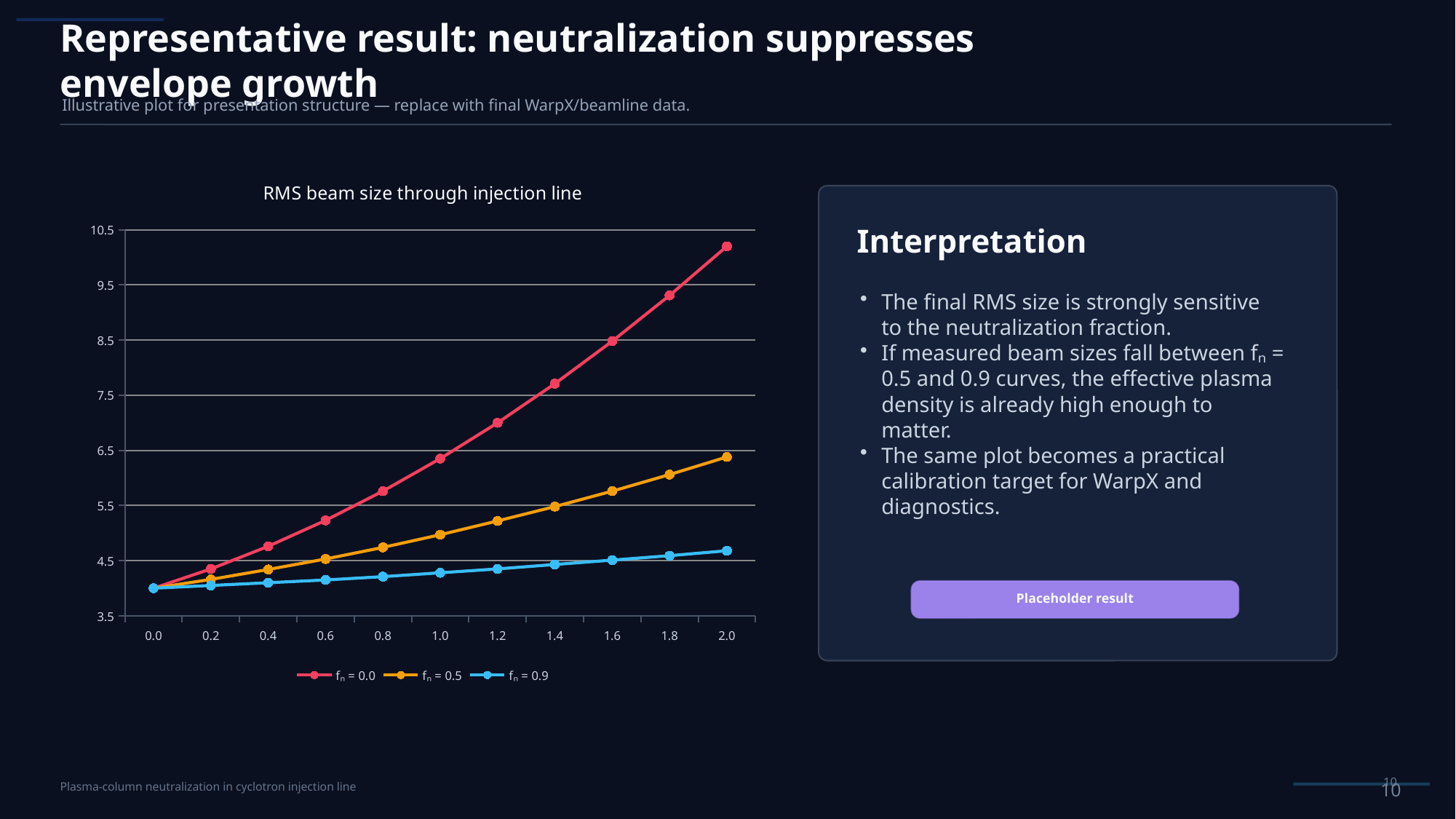
What kind of chart is shown on the slide? line chart How many x-axis points are plotted for each series? 11 Which series has the highest value at x = 2.0? fn = 0.0 Is the value of the fn = 0.0 series at x = 1.4 greater or less than 6.5? greater How many series does the chart legend list? 3 Which series has the lowest value at x = 2.0? fn = 0.9 Is the value of the fn = 0.5 series at x = 2.0 greater or less than 5.5? greater At x = 1.0, which series has the larger value, fn = 0.5 or fn = 0.9? fn = 0.5 Is the value of the fn = 0.0 series at x = 2.0 greater or less than 9.5? greater What is the title of the chart? RMS beam size through injection line Do the values of the fn = 0.0 series rise or fall as x increases from 0.0 to 2.0? rise